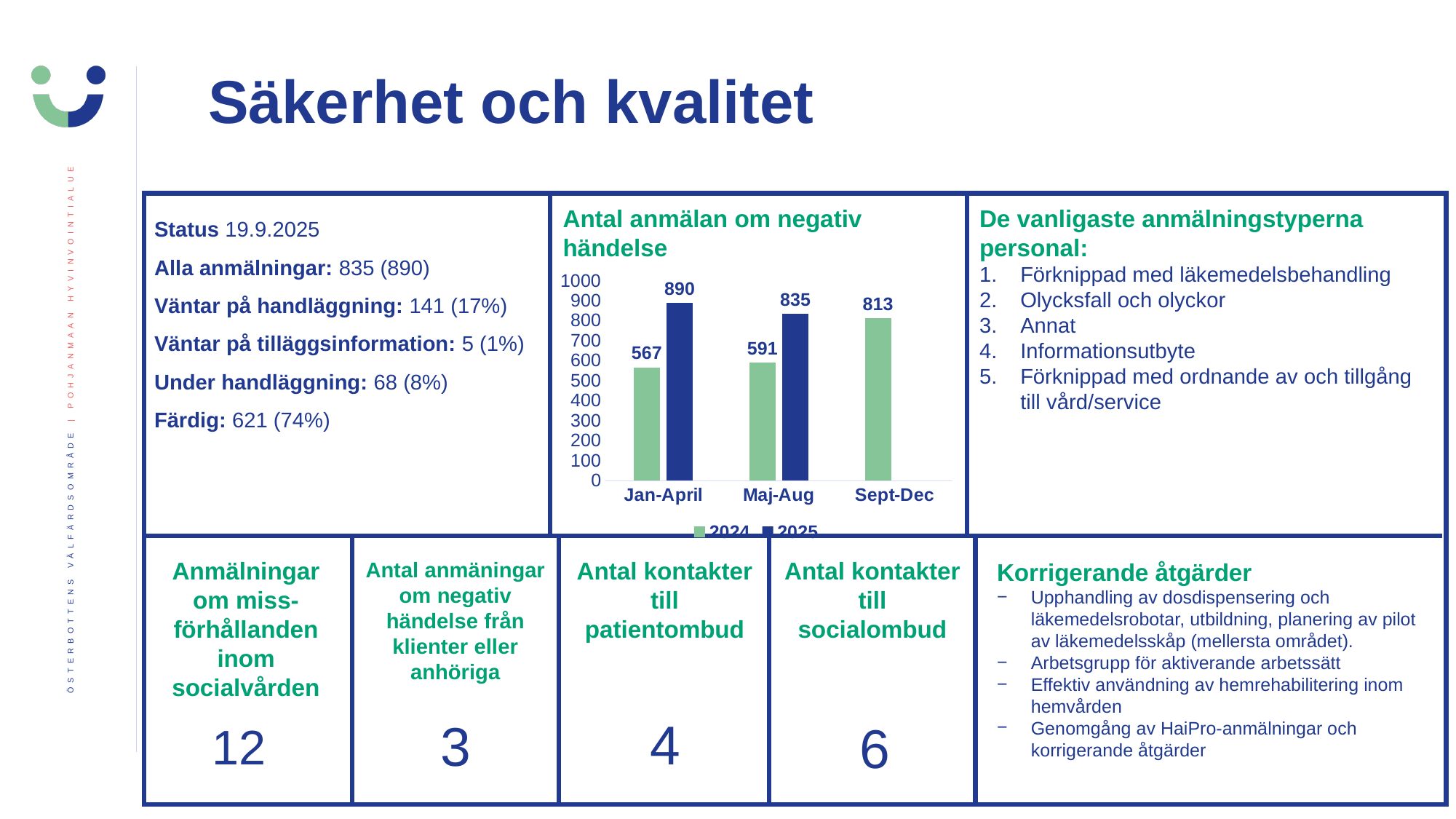
How many periods are shown on the x axis of the chart? 3 Which period has the highest value for the 2024 series? Sept-Dec What is the value for 2024 in Jan-April? 567 What kind of chart is shown on the slide? Bar chart What is the difference between the 2025 and 2024 values in Jan-April? 323 How many series does the chart legend list? 2 Which is larger in Maj-Aug, the 2024 value or the 2025 value? 2025 What is the difference between the 2025 and 2024 values in Maj-Aug? 244 What is the value for 2025 in Maj-Aug? 835 What is the value for 2024 in Sept-Dec? 813 What is the title of the chart? Antal anmälan om negativ händelse Which period has the lowest value for the 2024 series? Jan-April